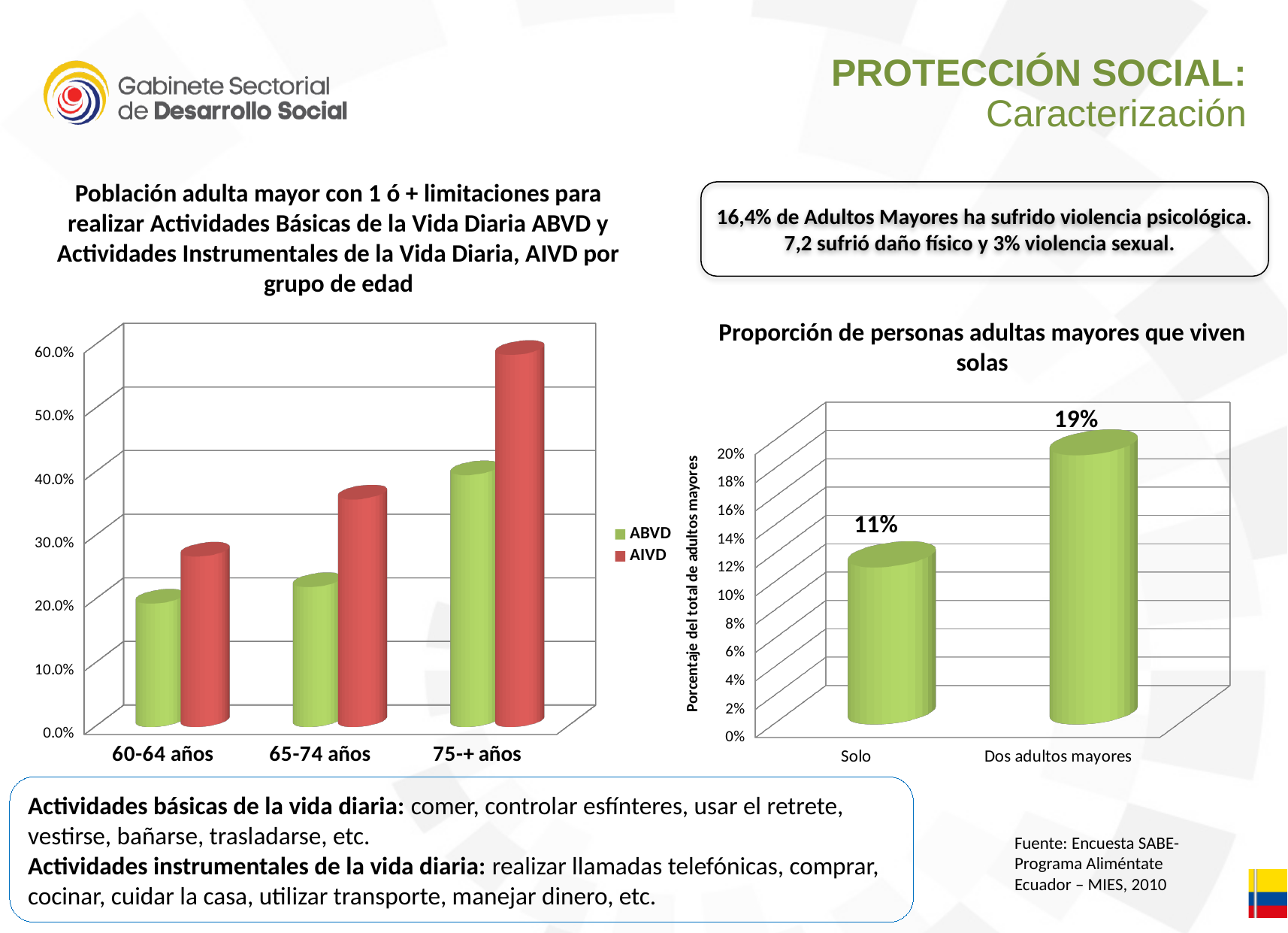
In the left chart on limitations for ABVD and AIVD by age group, is the ABVD value for '65-74 años' greater or less than 30.0%? less In the chart 'Proporción de personas adultas mayores que viven solas', how many categories are shown? 2 In the left chart on limitations for ABVD and AIVD by age group, which age group has the highest AIVD value? 75-+ años In the left chart on limitations for ABVD and AIVD by age group, is the AIVD value for '75-+ años' greater or less than 50.0%? greater In the chart 'Proporción de personas adultas mayores que viven solas', what is the value for 'Dos adultos mayores'? 19% In the chart 'Proporción de personas adultas mayores que viven solas', what is the difference between 'Dos adultos mayores' and 'Solo'? 8% In the left chart on limitations for ABVD and AIVD by age group, how many series does the legend list? 2 In the left chart on limitations for ABVD and AIVD by age group, do the AIVD values rise or fall as the age group increases? rise In the left chart on limitations for ABVD and AIVD by age group, which age group has the lowest ABVD value? 60-64 años In the chart 'Proporción de personas adultas mayores que viven solas', what is the value for 'Solo'? 11% In the chart 'Proporción de personas adultas mayores que viven solas', which category has the higher value? Dos adultos mayores In the left chart on limitations for ABVD and AIVD by age group, for '60-64 años', which series has the larger value, ABVD or AIVD? AIVD